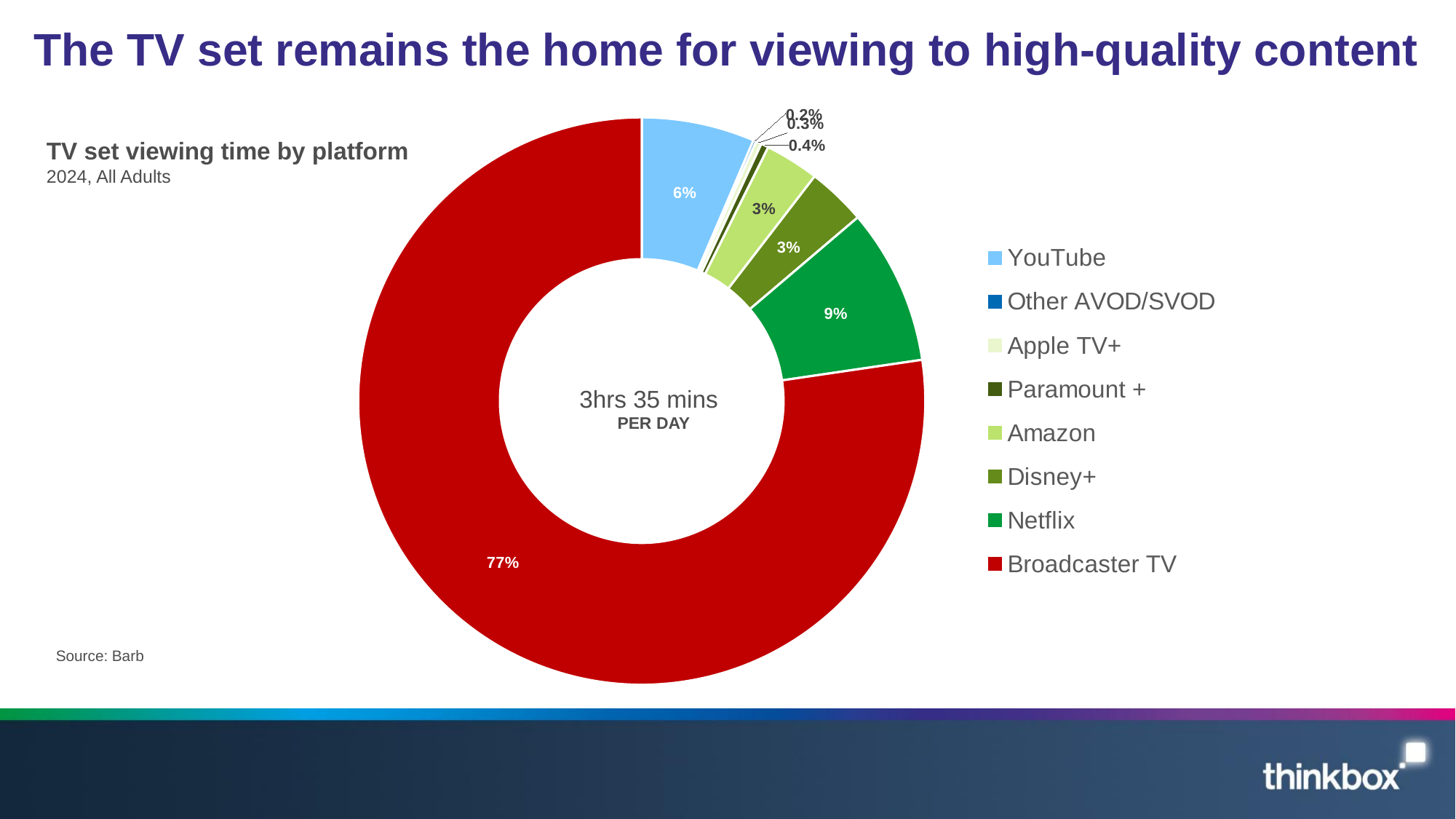
How many percentage points larger is Netflix's share than YouTube's? 3 percentage points What percentage of TV set viewing time is Disney+? 3% What percentage of TV set viewing time is Netflix? 9% Which has a larger share of TV set viewing time, Netflix or YouTube? Netflix What share of TV set viewing time does Broadcaster TV account for? 77% What percentage of TV set viewing time is YouTube? 6% What percentage of TV set viewing time is Amazon? 3% What kind of chart is shown on the slide? Pie (doughnut) chart What total daily viewing time is shown in the centre of the chart? 3hrs 35 mins per day Which platform has the largest share of TV set viewing time? Broadcaster TV How many percentage points larger is Broadcaster TV's share than Netflix's? 68 percentage points How many platforms are listed in the chart legend? 8